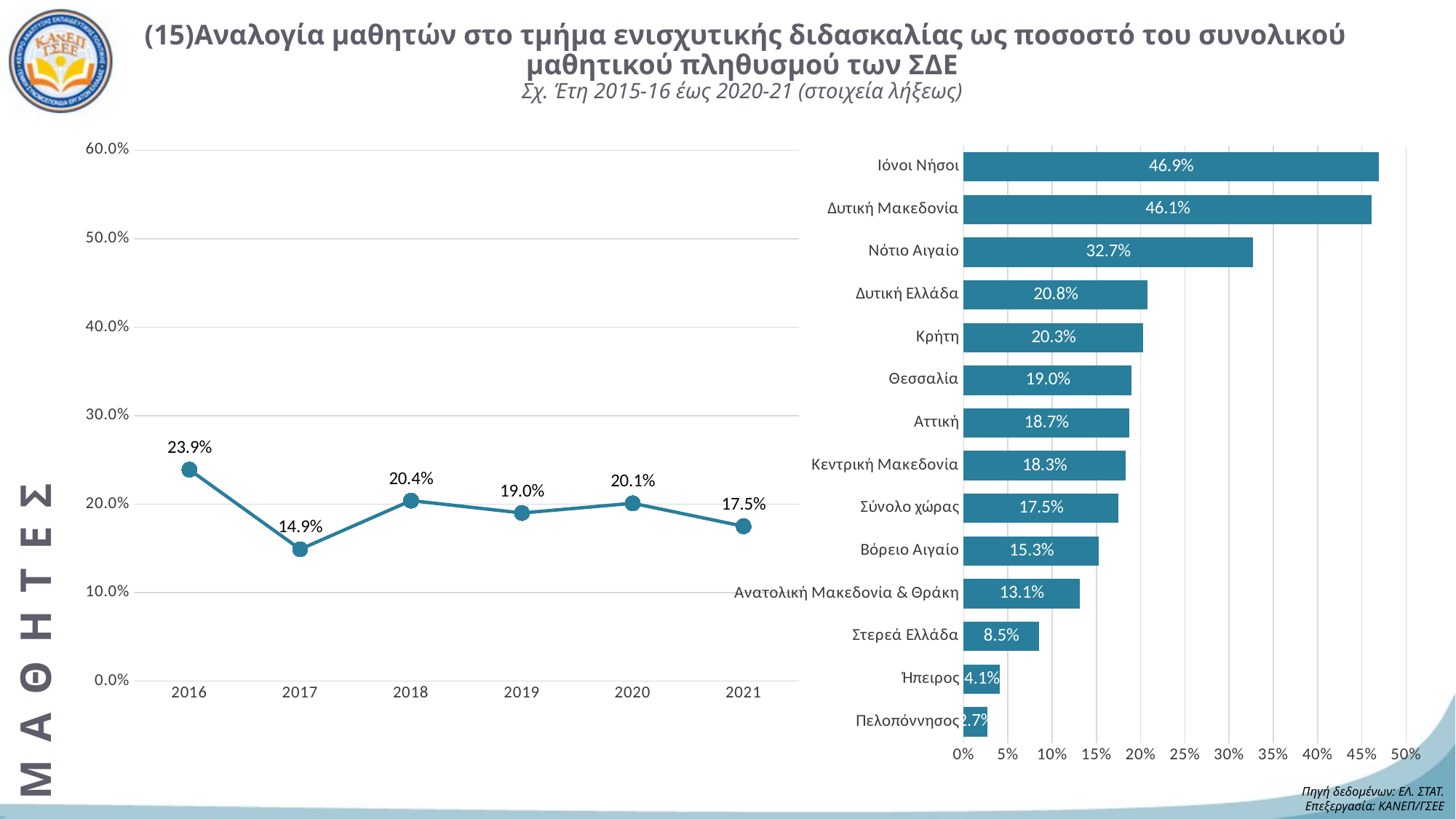
In the bar chart on the right, which category has the lowest value? Πελοπόννησος In the bar chart on the right, what is the value for Κρήτη? 20.3% What kind of chart is the chart on the right? bar chart In the bar chart on the right, which region has the highest value? Ιόνοι Νήσοι In the line chart on the left, which year has the lowest value? 2017 In the line chart on the left, how many years are plotted? 6 In the line chart on the left, is the value for 2018 greater or less than the value for 2020? greater In the bar chart on the right, how many categories are shown? 14 In the bar chart on the right, what is the difference between Ιόνιοι Νήσοι and Δυτική Μακεδονία? 0.8% What kind of chart is the chart on the left? line chart In the line chart on the left, what is the value for 2016? 23.9% In the line chart on the left, what is the difference between the values for 2016 and 2021? 6.4%